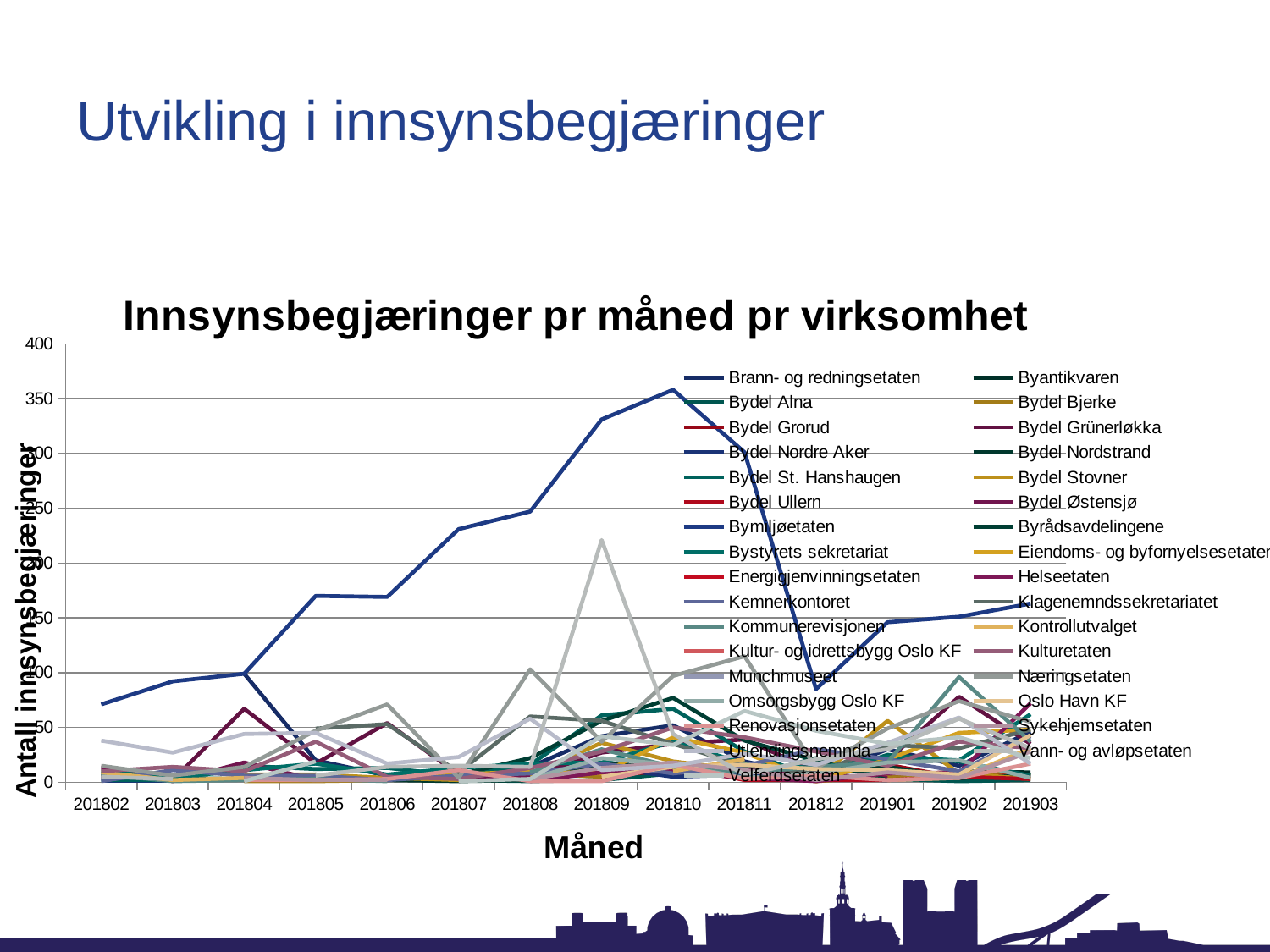
What kind of chart is shown on the slide? line chart How many series does the legend list? 33 In which month does the highest line on the chart reach its peak? 201810 Is the value of the highest line at 201812 greater or less than 150? less Does the highest line rise or fall between 201802 and 201810? rise Is the value of the highest line at 201802 greater or less than 100? less What is the label of the vertical axis? Antall innsynsbegjæringer Is the peak value of the highest line at 201810 greater or less than 300? greater Does the highest line rise or fall between 201810 and 201812? fall What is the title of the chart? Innsynsbegjæringer pr måned pr virksomhet How many months are shown along the x axis? 14